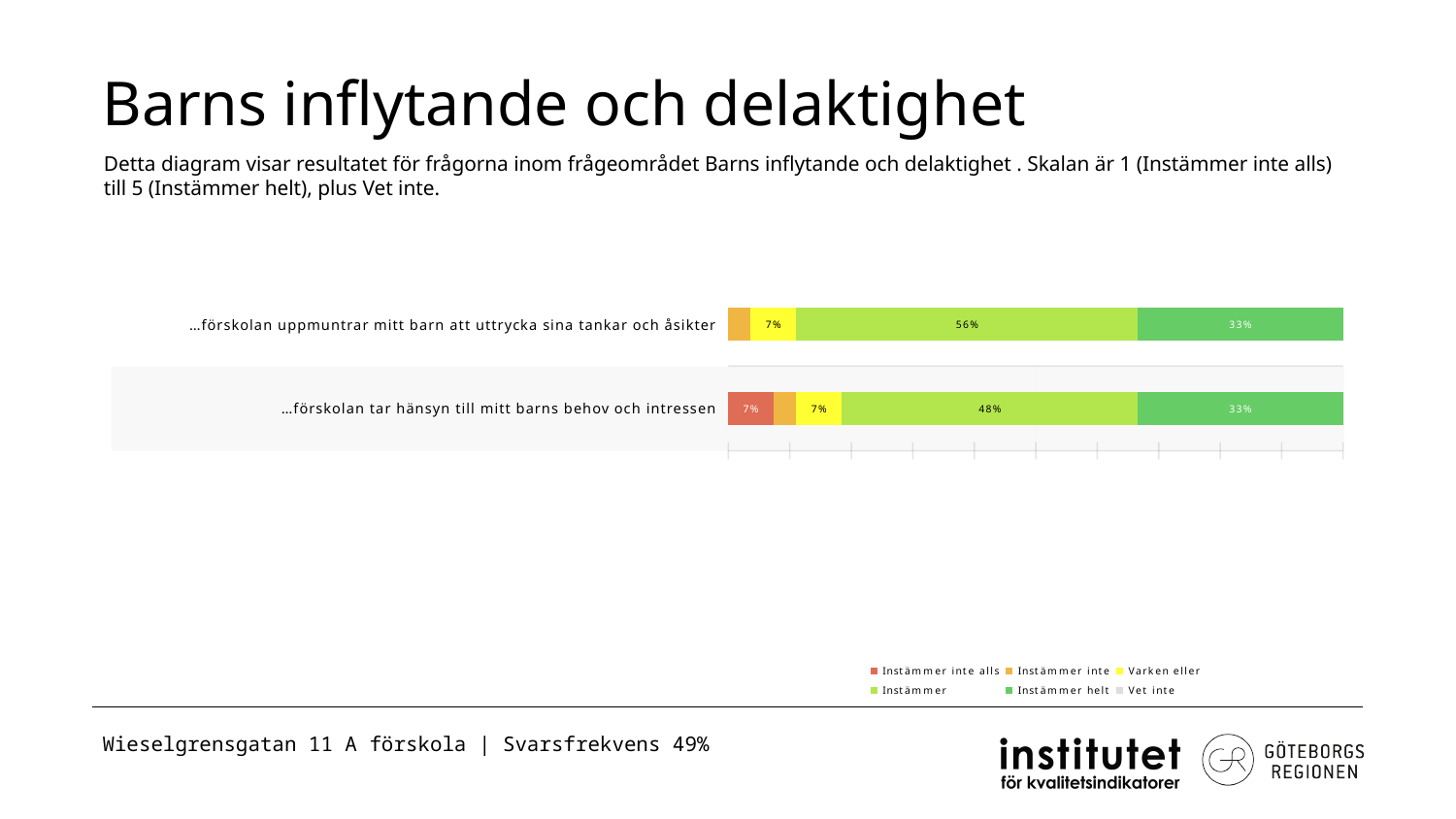
What is the 'Instämmer inte alls' value for '…förskolan tar hänsyn till mitt barns behov och intressen'? 7% Which category has the higher 'Instämmer' value? …förskolan uppmuntrar mitt barn att uttrycka sina tankar och åsikter How many series does the legend list? 6 How many categories (questions) are plotted in the chart? 2 What is the 'Instämmer helt' value for '…förskolan tar hänsyn till mitt barns behov och intressen'? 33% What is the difference between the 'Instämmer' values of the two categories? 8% Which category has the larger 'Instämmer helt' segment, or are they equal? equal What is the 'Instämmer' value for '…förskolan uppmuntrar mitt barn att uttrycka sina tankar och åsikter'? 56% What is the 'Instämmer' value for '…förskolan tar hänsyn till mitt barns behov och intressen'? 48% What is the 'Varken eller' value for '…förskolan uppmuntrar mitt barn att uttrycka sina tankar och åsikter'? 7% What kind of chart is shown on the slide? stacked bar chart What is the title of the slide containing the chart? Barns inflytande och delaktighet